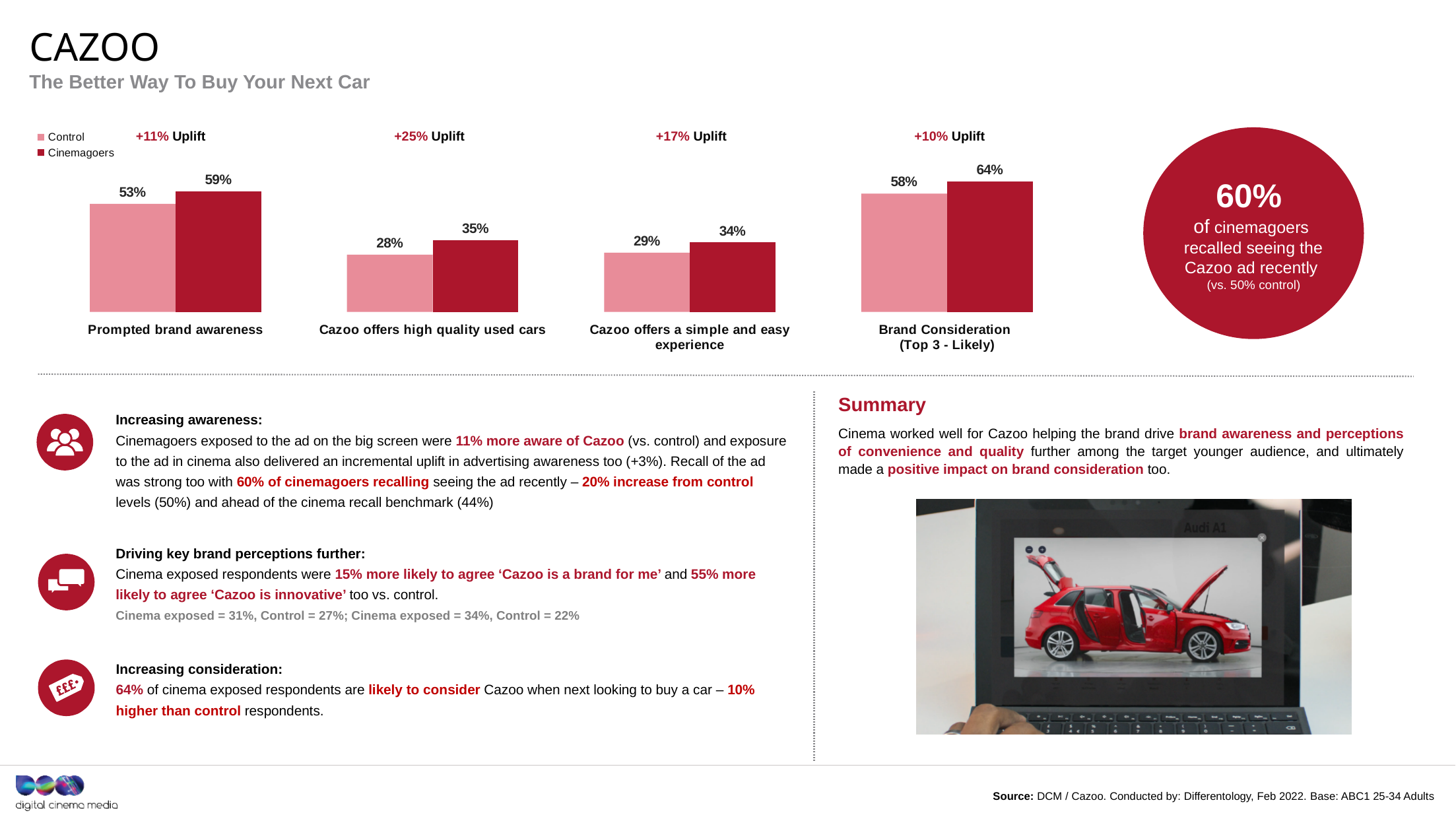
How many series does the legend list for the bar charts? 2 In the 'Brand Consideration (Top 3 - Likely)' chart, what is the value for Cinemagoers? 64% In the 'Prompted brand awareness' chart, what is the value for Cinemagoers? 59% In the 'Cazoo offers a simple and easy experience' chart, which is larger, the Control value or the Cinemagoers value? Cinemagoers In the 'Cazoo offers high quality used cars' chart, what is the value for Control? 28% In the 'Prompted brand awareness' chart, what is the value for Control? 53% In the 'Brand Consideration (Top 3 - Likely)' chart, what is the difference between the Cinemagoers and Control values? 6% Which series is shown in the darker red colour in the bar charts? Cinemagoers In the 'Cazoo offers high quality used cars' chart, what is the difference between the Cinemagoers and Control values? 7% In the 'Cazoo offers a simple and easy experience' chart, what is the value for Cinemagoers? 34% How many bars are shown in the 'Brand Consideration (Top 3 - Likely)' chart? 2 What kind of chart is the 'Prompted brand awareness' chart? Bar chart